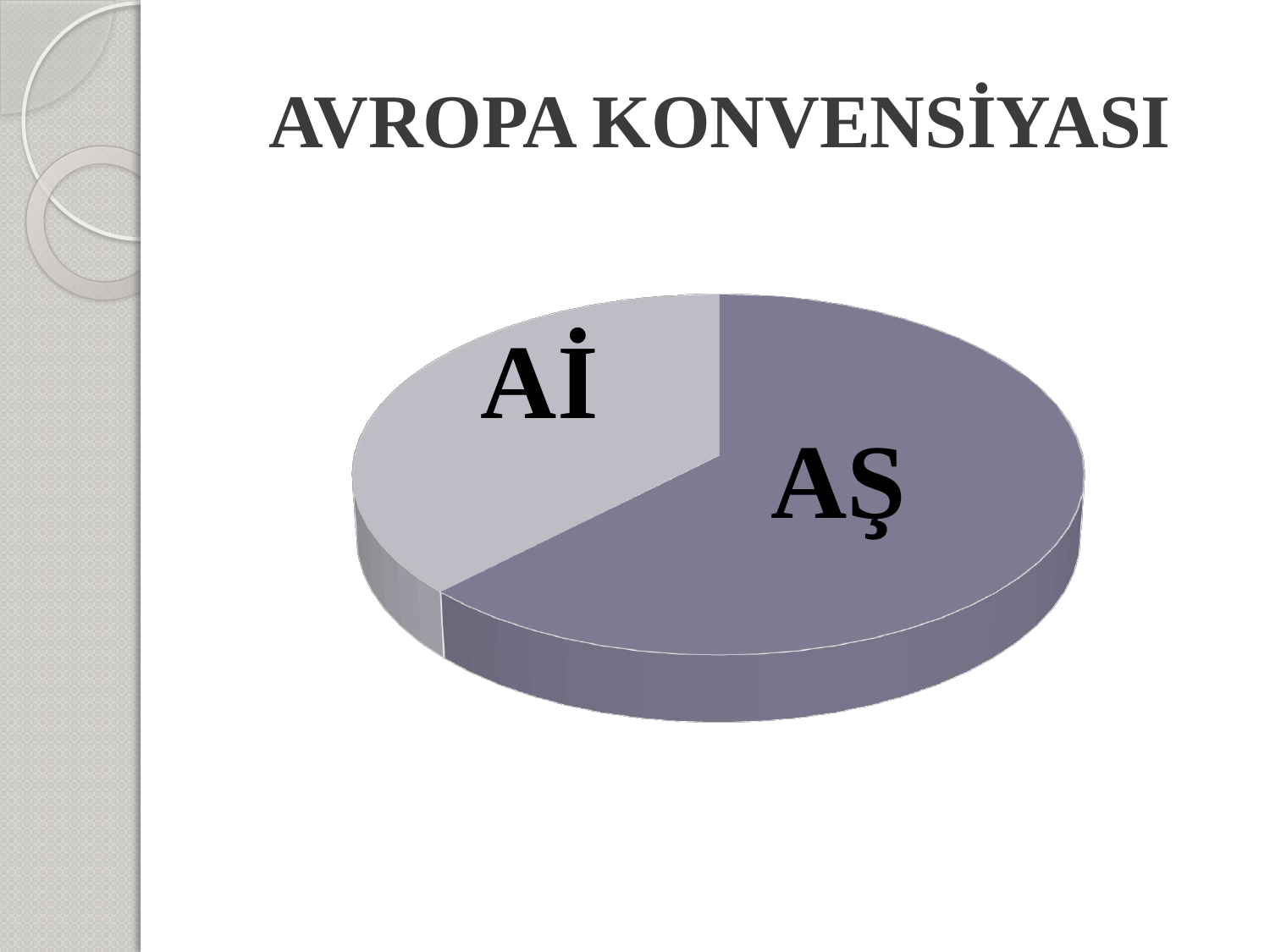
What kind of chart is shown on the slide? Pie chart Which slice is larger, Aİ or AŞ? AŞ Which slice of the pie chart is shown in the lighter colour? Aİ How many slices does the pie chart have? 2 Which slice of the pie chart is the largest? AŞ Which slice of the pie chart is the smallest? Aİ What is the title of the slide containing the pie chart? AVROPA KONVENSİYASI Does the AŞ slice take up more or less than half of the pie? More